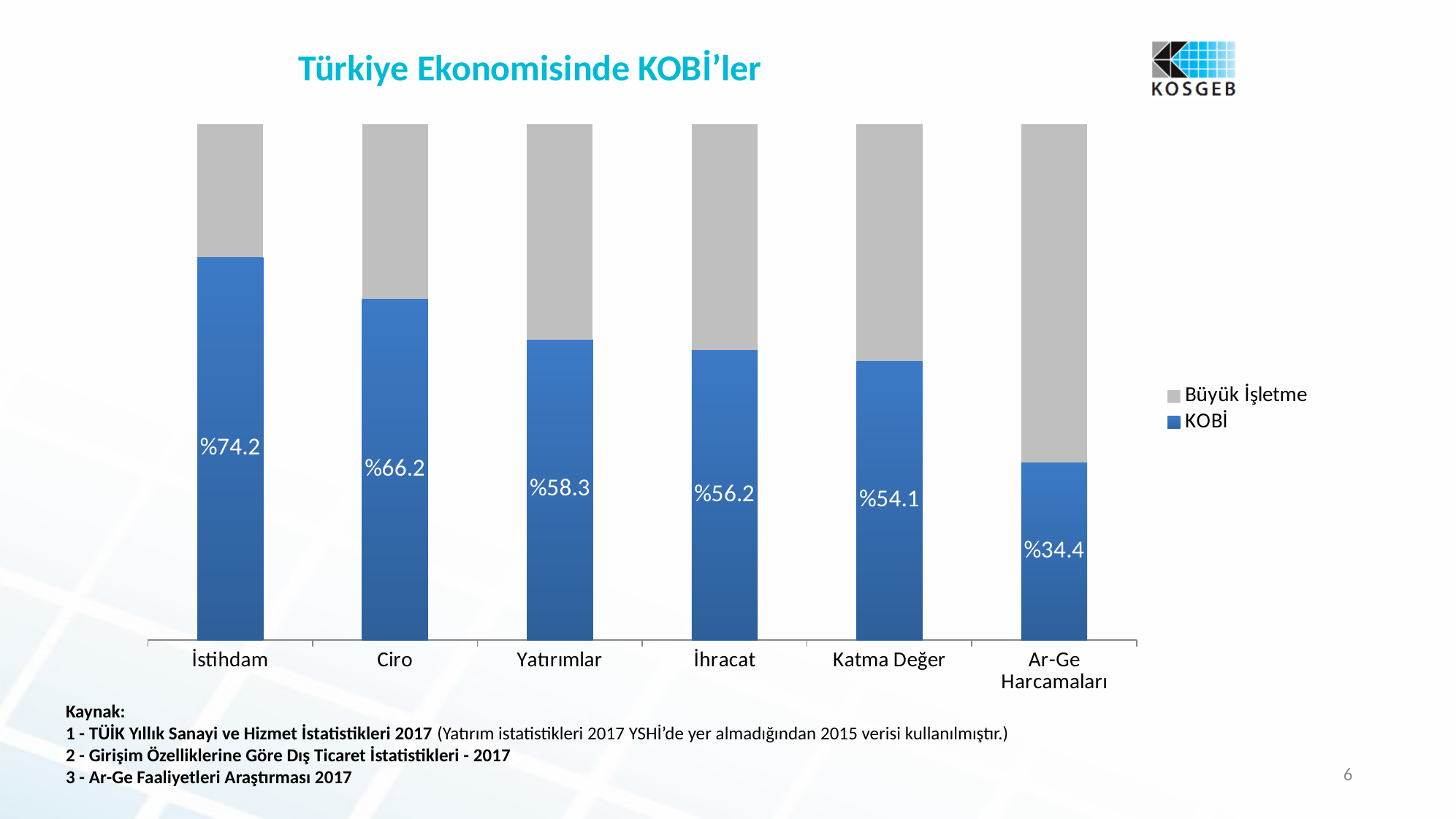
What is the difference between the KOBİ share for İstihdam and for Ar-Ge Harcamaları? 39.8 percentage points Which category has the highest KOBİ share? İstihdam What kind of chart is shown on the slide? Stacked bar chart What is the KOBİ share for Katma Değer? %54.1 How many categories are shown on the x axis? 6 What is the KOBİ share for Yatırımlar? %58.3 Which category has the lowest KOBİ share? Ar-Ge Harcamaları Do the KOBİ shares rise or fall from left to right along the x axis? Fall How many series does the legend list? 2 Which has a larger KOBİ share, Ciro or İhracat? Ciro What is the KOBİ share for Ar-Ge Harcamaları? %34.4 What is the KOBİ share for İstihdam? %74.2